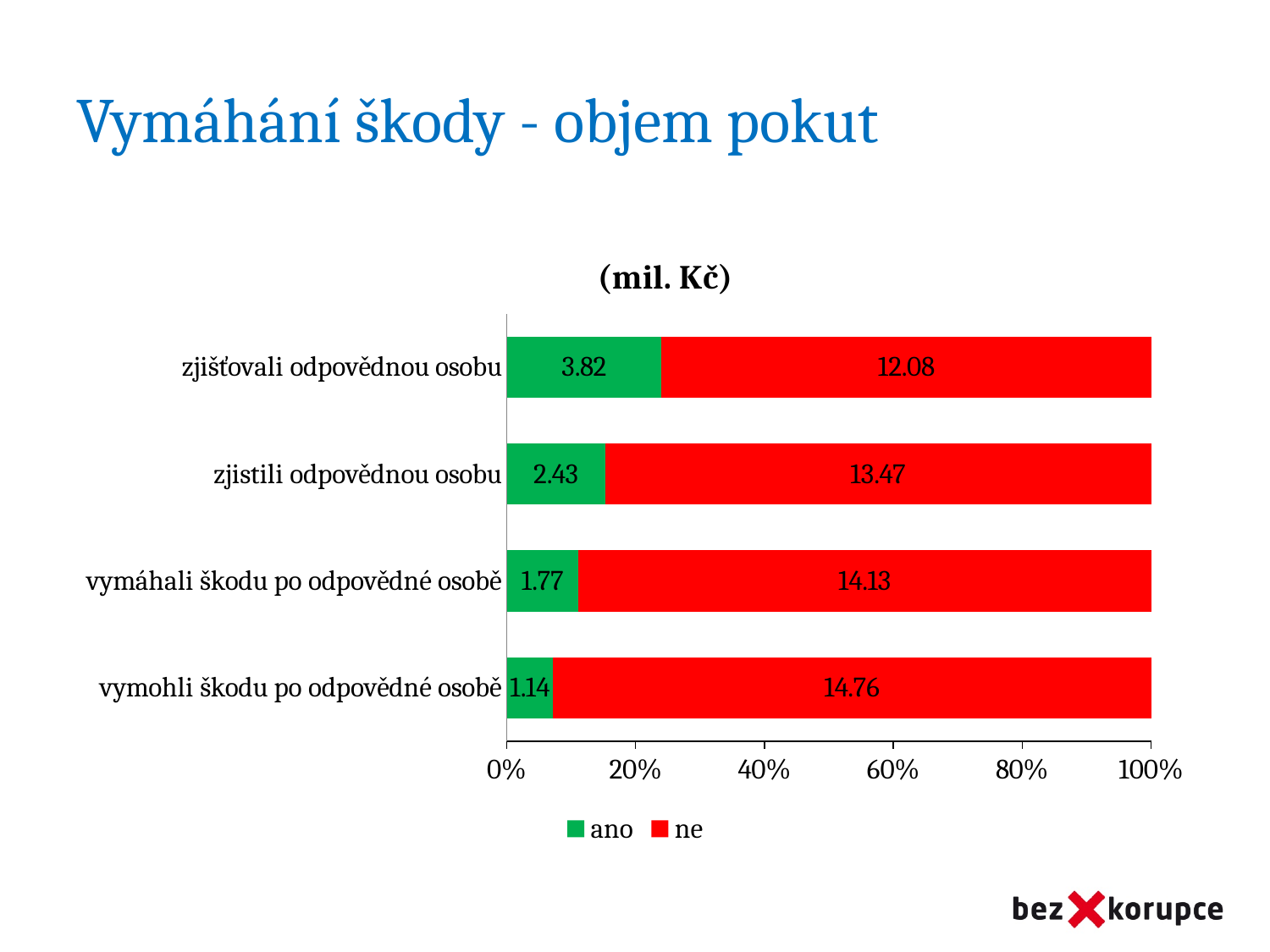
Which category has the lowest 'ne' value? zjišťovali odpovědnou osobu Which category has the highest 'ano' value? zjišťovali odpovědnou osobu What is the value of the 'ano' series for 'vymohli škodu po odpovědné osobě'? 1.14 What is the value of the 'ne' series for 'zjistili odpovědnou osobu'? 13.47 How many categories are shown on the chart? 4 How many series does the legend list? 2 Is the 'ano' share of the bar for 'zjišťovali odpovědnou osobu' greater or less than 20%? greater What is the value of the 'ne' series for 'vymáhali škodu po odpovědné osobě'? 14.13 What kind of chart is shown on the slide? stacked bar chart What is the value of the 'ano' series for 'zjišťovali odpovědnou osobu'? 3.82 What is the difference between the 'ne' and 'ano' values for 'zjišťovali odpovědnou osobu'? 8.26 Which is larger: the 'ano' value for 'zjistili odpovědnou osobu' or the 'ano' value for 'vymáhali škodu po odpovědné osobě'? zjistili odpovědnou osobu